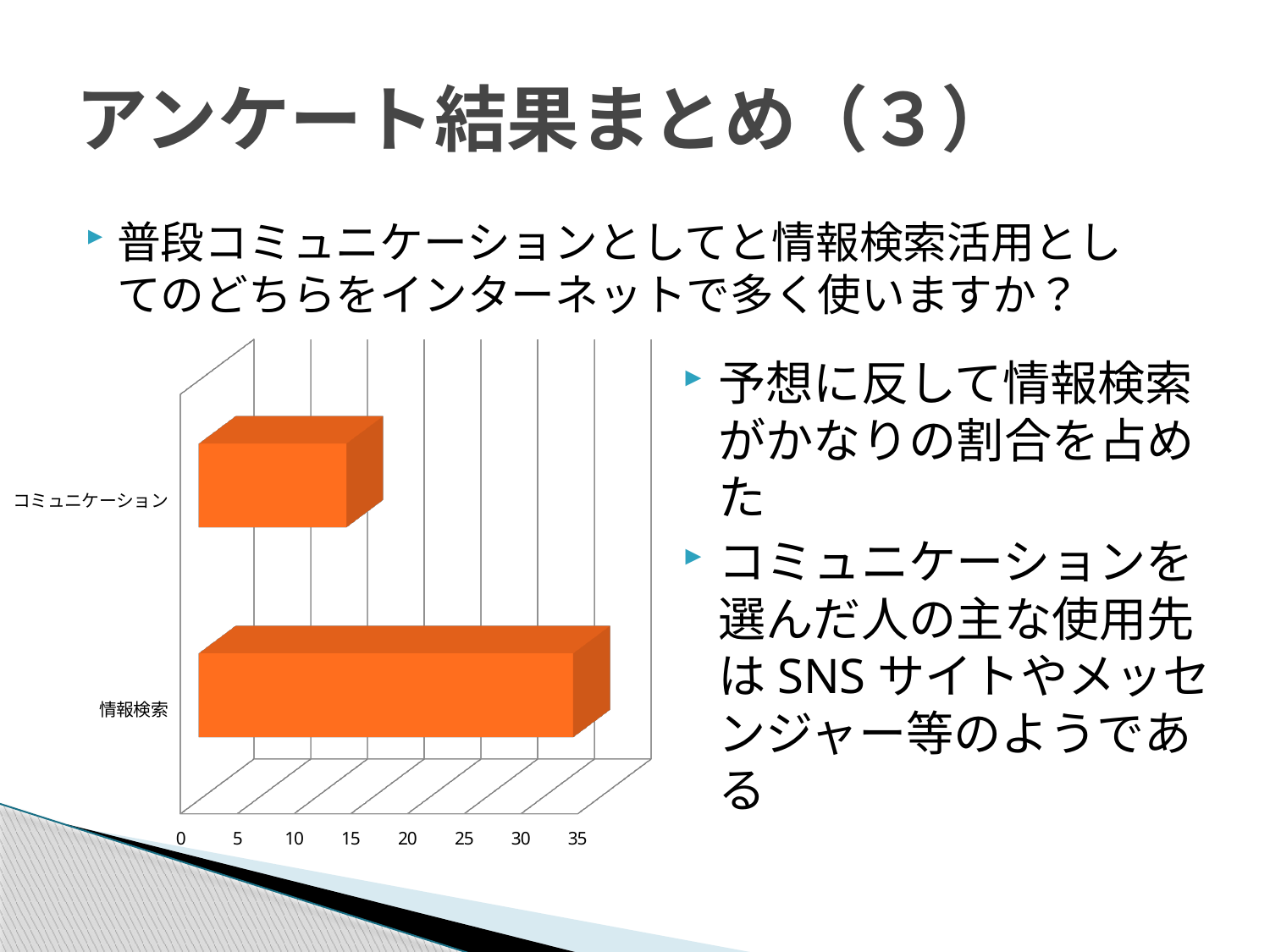
Is the value for 情報検索 greater or less than 30? greater What is the highest tick value shown on the value axis of the chart? 35 Which category has the lowest value in the chart? コミュニケーション Is the value for コミュニケーション greater or less than 20? less Is the value for コミュニケーション greater or less than 10? greater What colour are the bars in the chart? orange Which is larger, the value for 情報検索 or the value for コミュニケーション? 情報検索 Which category has the highest value in the chart? 情報検索 How many categories are plotted in the chart? 2 What kind of chart is shown on the slide? bar chart